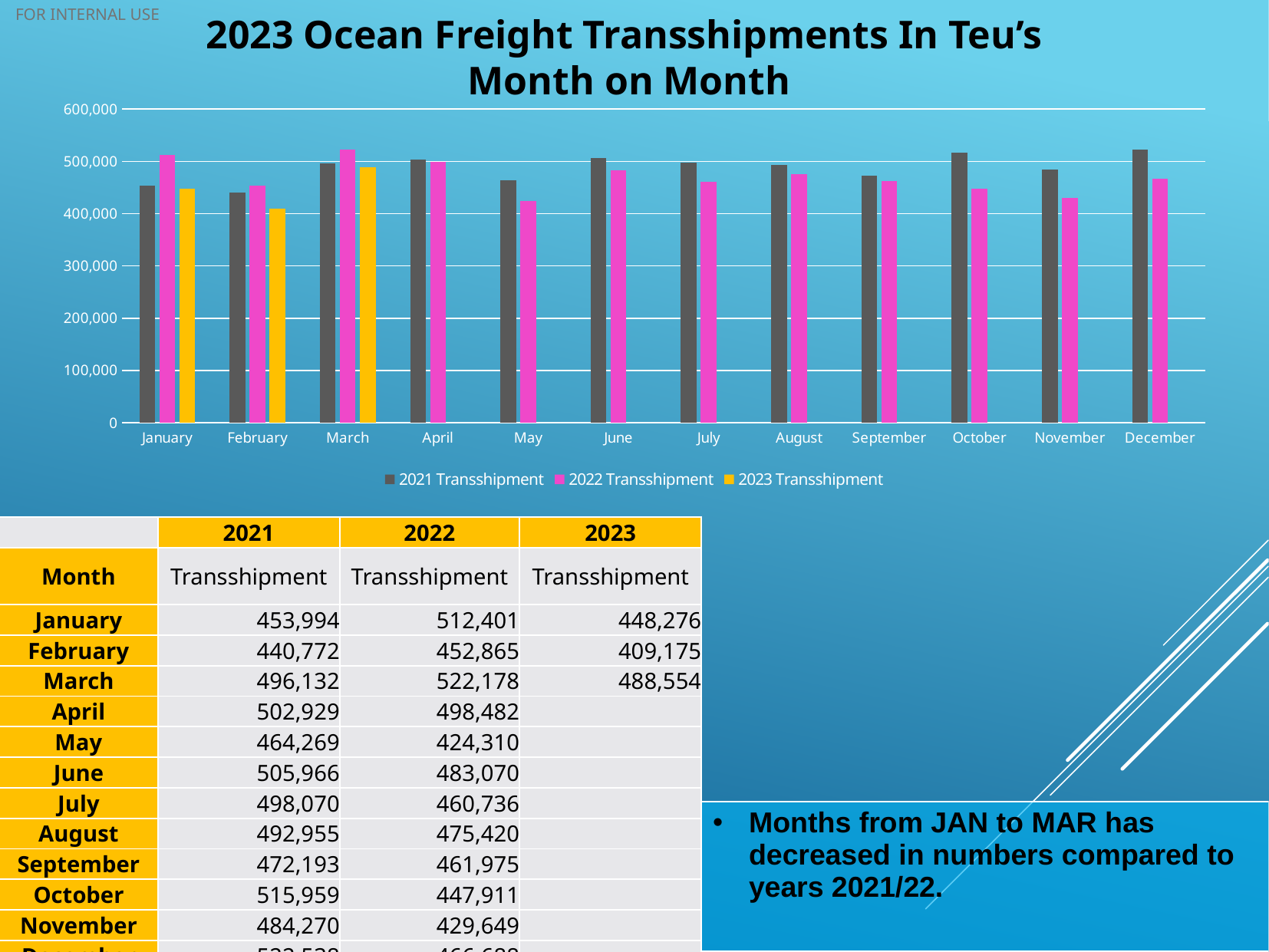
What kind of chart is shown on the slide? Bar chart Which month has the lowest 2023 Transshipment value? February For May, which is larger: the 2021 Transshipment or the 2022 Transshipment? 2021 Transshipment Which month has the highest 2022 Transshipment value? March What colour represents the 2023 Transshipment series in the chart? Yellow How many series does the chart legend list? 3 What is the difference between the 2022 and 2021 Transshipment values for January? 58,407 What is the 2022 Transshipment value for January? 512,401 How many months are shown along the x axis of the chart? 12 Is the 2021 Transshipment value for October greater or less than 500,000? greater What is the 2023 Transshipment value for March? 488,554 Does the 2023 Transshipment value rise or fall from January to February? Fall